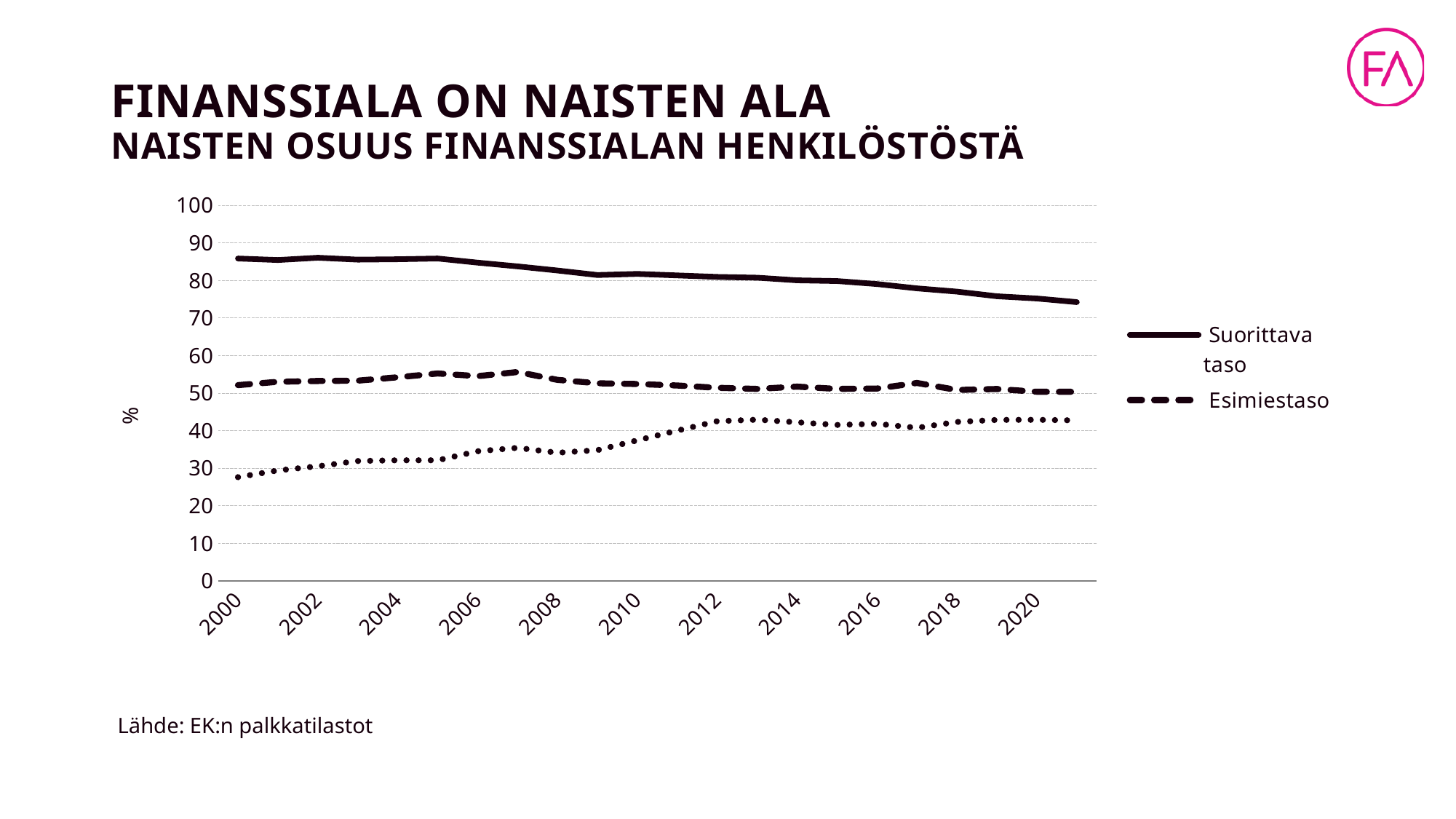
Is the value for Suorittava taso in 2020 greater or less than 80? less Is the value for Suorittava taso in 2000 greater or less than 80? greater What is the source given below the chart? EK:n palkkatilastot What kind of chart is shown on the slide? line chart Which series has the higher value in 2010, Suorittava taso or Esimiestaso? Suorittava taso Is the value for Suorittava taso in 2020 greater or less than 70? greater How many year labels are shown on the x axis? 11 Does the Suorittava taso line rise or fall from 2000 to 2020? fall How many series does the legend list? 2 Is the value for Suorittava taso higher in 2000 or in 2020? 2000